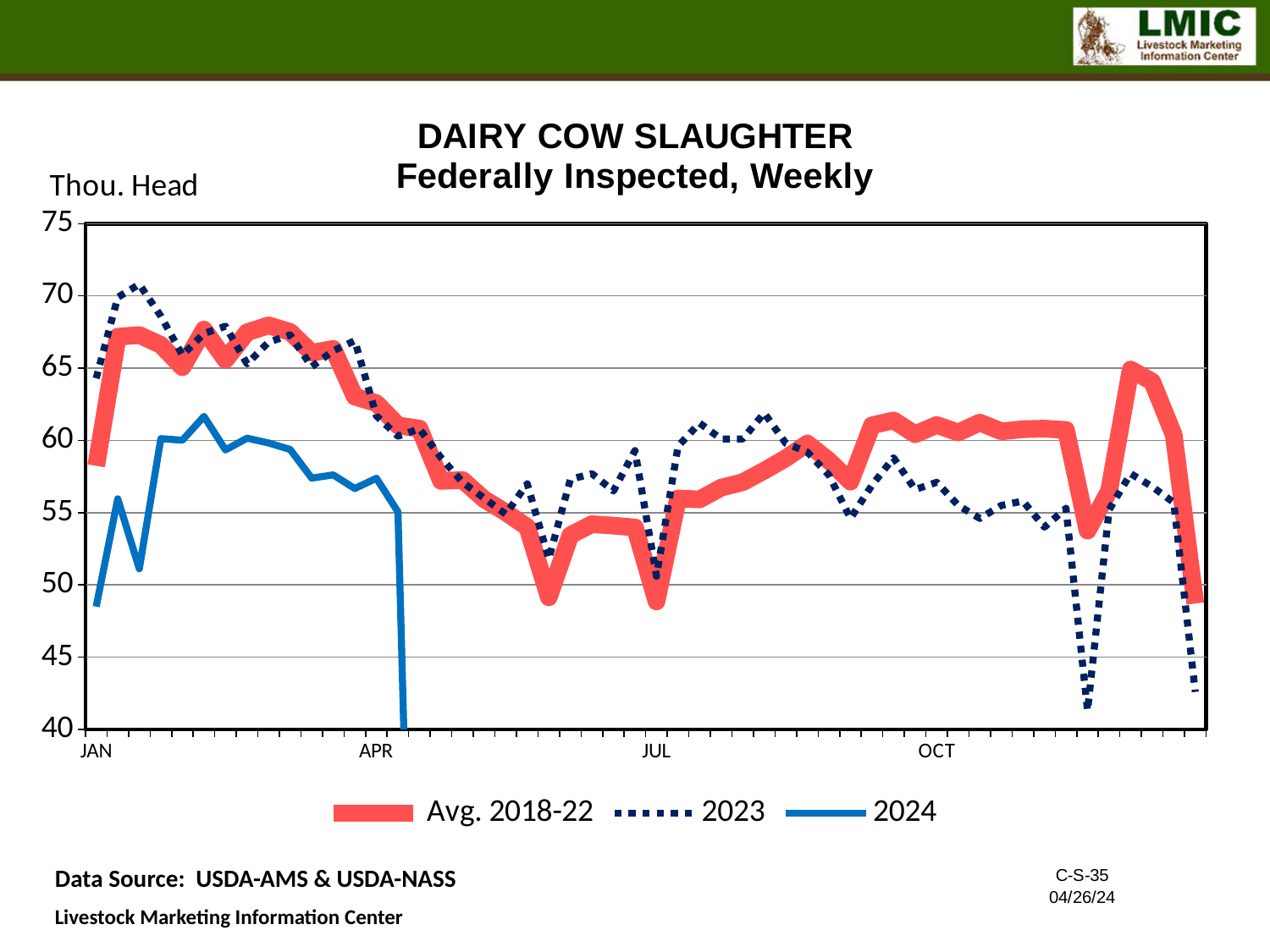
Is the value of the Avg. 2018-22 series in October greater or less than 60? greater What unit is shown on the y axis of the chart? Thou. Head What is the title of the chart? DAIRY COW SLAUGHTER Federally Inspected, Weekly In October, which series is higher, Avg. 2018-22 or 2023? Avg. 2018-22 How many series does the legend list? 3 Is the value of the 2024 series in March greater or less than 55? greater Does the Avg. 2018-22 series rise or fall between APR and JUL? fall What kind of chart is shown on the slide? line chart Is the lowest value of the 2023 series in late November greater or less than 45? less In March, which series is higher, 2024 or Avg. 2018-22? Avg. 2018-22